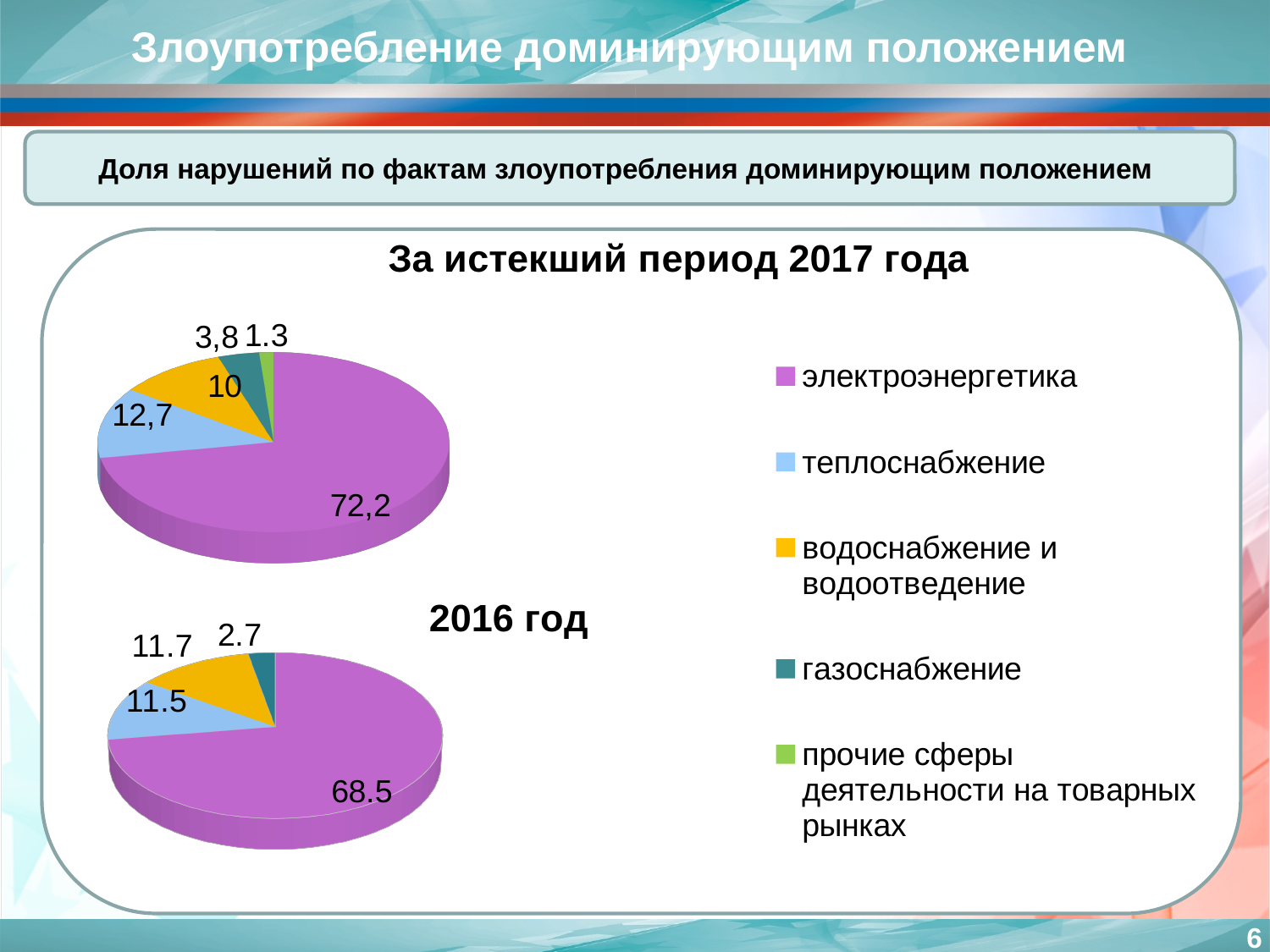
In the chart titled "За истекший период 2017 года", what is the value for теплоснабжение? 12,7 Which is larger: the value for электроэнергетика in the chart titled "За истекший период 2017 года" or in the chart titled "2016 год"? За истекший период 2017 года In the chart titled "2016 год", what is the value for электроэнергетика? 68.5 In the chart titled "За истекший период 2017 года", which category has the largest slice? электроэнергетика In the chart titled "2016 год", which category has the smallest slice? газоснабжение In the chart titled "За истекший период 2017 года", which category has the smallest slice? прочие сферы деятельности на товарных рынках What type of chart is the chart titled "За истекший период 2017 года"? pie chart How many slices does the chart titled "2016 год" have? 4 In the chart titled "2016 год", what is the value for газоснабжение? 2.7 In the chart titled "За истекший период 2017 года", what is the difference between the values for теплоснабжение and водоснабжение и водоотведение? 2,7 In the chart titled "За истекший период 2017 года", what is the value for электроэнергетика? 72,2 How many entries does the legend on the slide list? 5